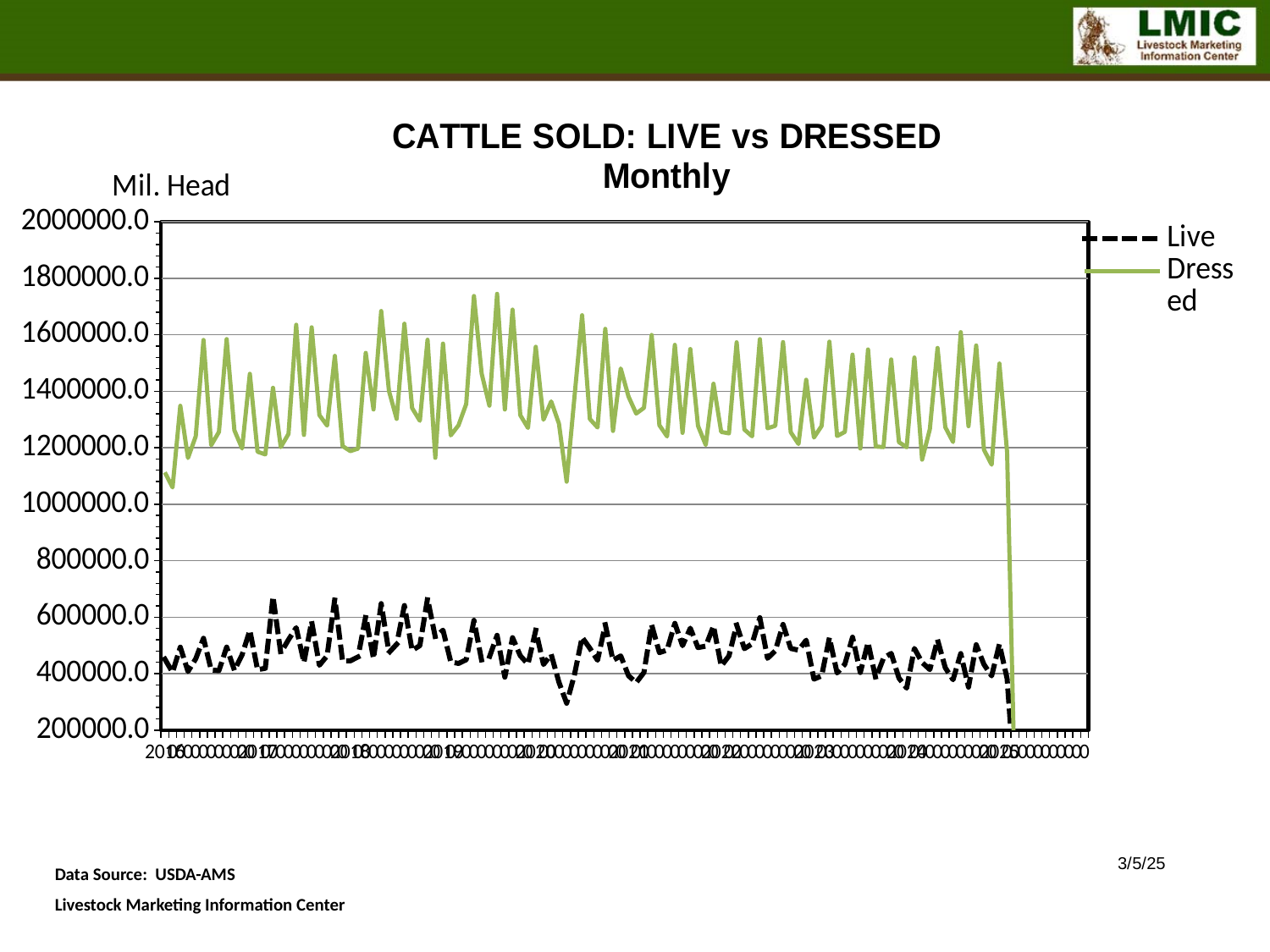
What unit label is shown above the vertical axis? Mil. Head Are the values for the Dressed series generally greater or less than 1000000.0? greater What kind of chart is shown on the slide? Line chart Which series is plotted with a dashed black line? Live Are the values for the Live series generally greater or less than 800000.0? less How many series does the legend list? 2 What is the last year shown on the horizontal axis? 2025 Which series has higher values throughout the chart, Live or Dressed? Dressed What is the lowest value shown on the vertical axis? 200000.0 What is the title of the chart? CATTLE SOLD: LIVE vs DRESSED Monthly What is the first year shown on the horizontal axis? 2016 What is the highest value shown on the vertical axis? 2000000.0